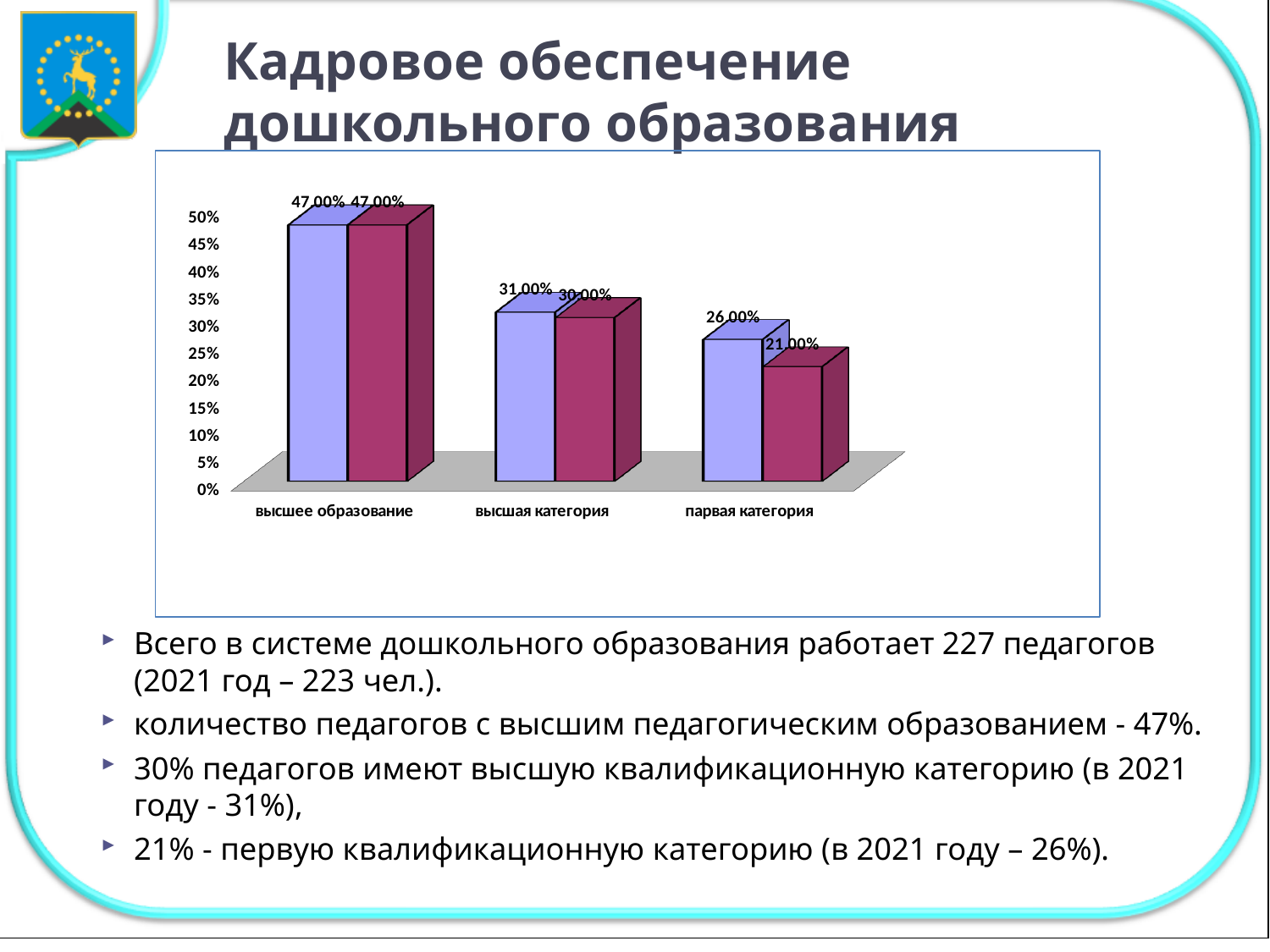
What is the value of the magenta bar for "парвая категория"? 21,00% For "высшая категория", which bar is larger, the light blue or the magenta one? light blue What is the difference between the light blue and magenta bars for "парвая категория"? 5,00% What kind of chart is shown on the slide? bar chart Do the values of the light blue bars rise or fall from left to right along the x axis? fall What is the value of the magenta bar for "высшая категория"? 30,00% What is the value of the light blue bar for "высшая категория"? 31,00% Which category has the lowest magenta bar? парвая категория What is the value of the light blue bar for "парвая категория"? 26,00% What is the value of the light blue bar for "высшее образование"? 47,00% How many categories are shown on the x axis of the chart? 3 Which category has the highest values in the chart? высшее образование